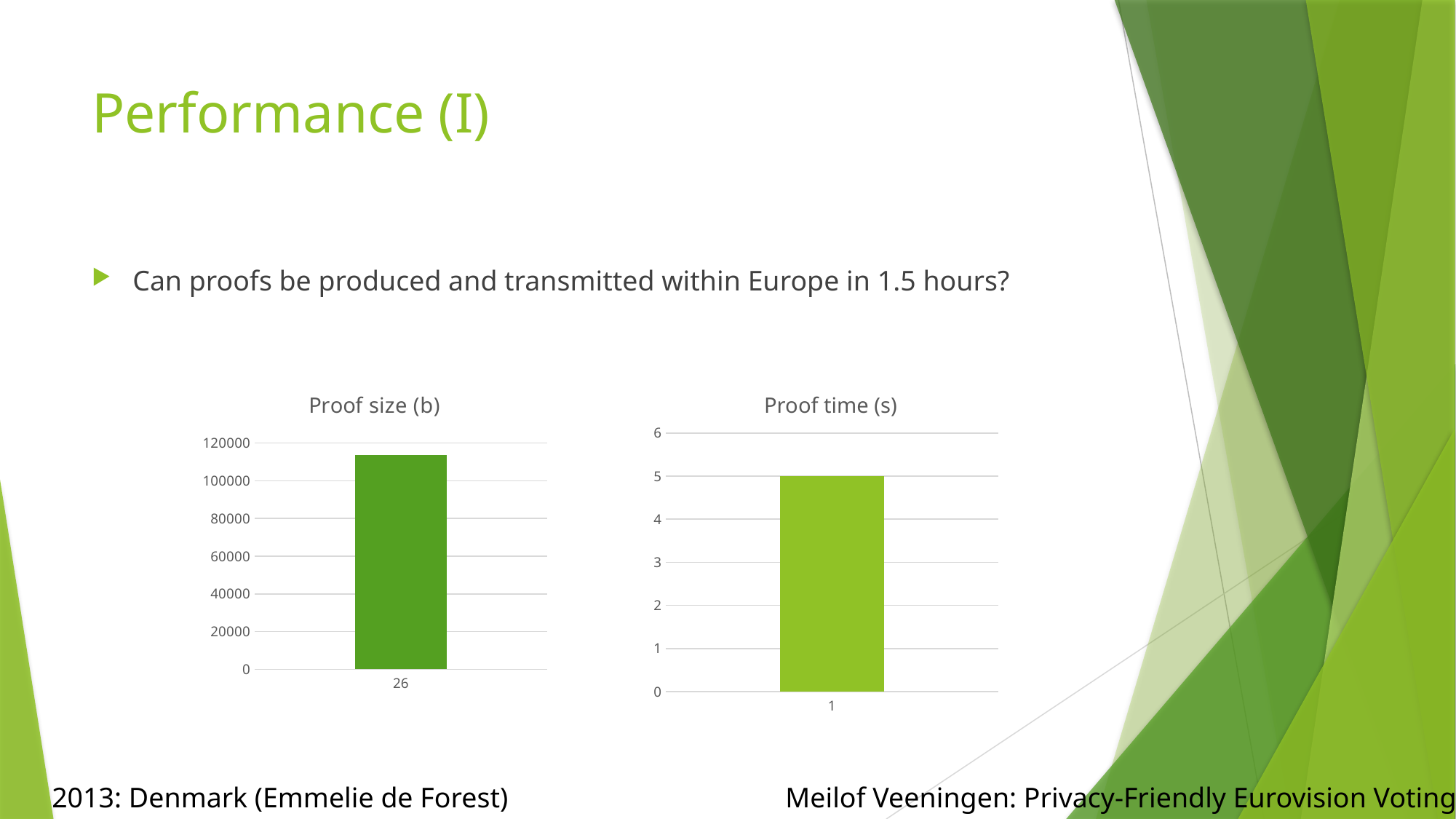
How many bars are plotted in the "Proof time (s)" chart? 1 In the "Proof size (b)" chart, is the value for category 26 greater or less than 120000? less In the "Proof time (s)" chart, what is the highest value shown on the y axis? 6 How many bars are plotted in the "Proof size (b)" chart? 1 What kind of chart is the "Proof size (b)" chart? bar chart What is the title of the chart on the right? Proof time (s) In the "Proof time (s)" chart, what is the value of the bar for category 1? 5 In the "Proof time (s)" chart, is the value for category 1 greater or less than 4? greater In the "Proof size (b)" chart, what is the category label on the x axis? 26 What kind of chart is the "Proof time (s)" chart? bar chart In the "Proof size (b)" chart, is the value for category 26 greater or less than 100000? greater What is the title of the chart on the left? Proof size (b)